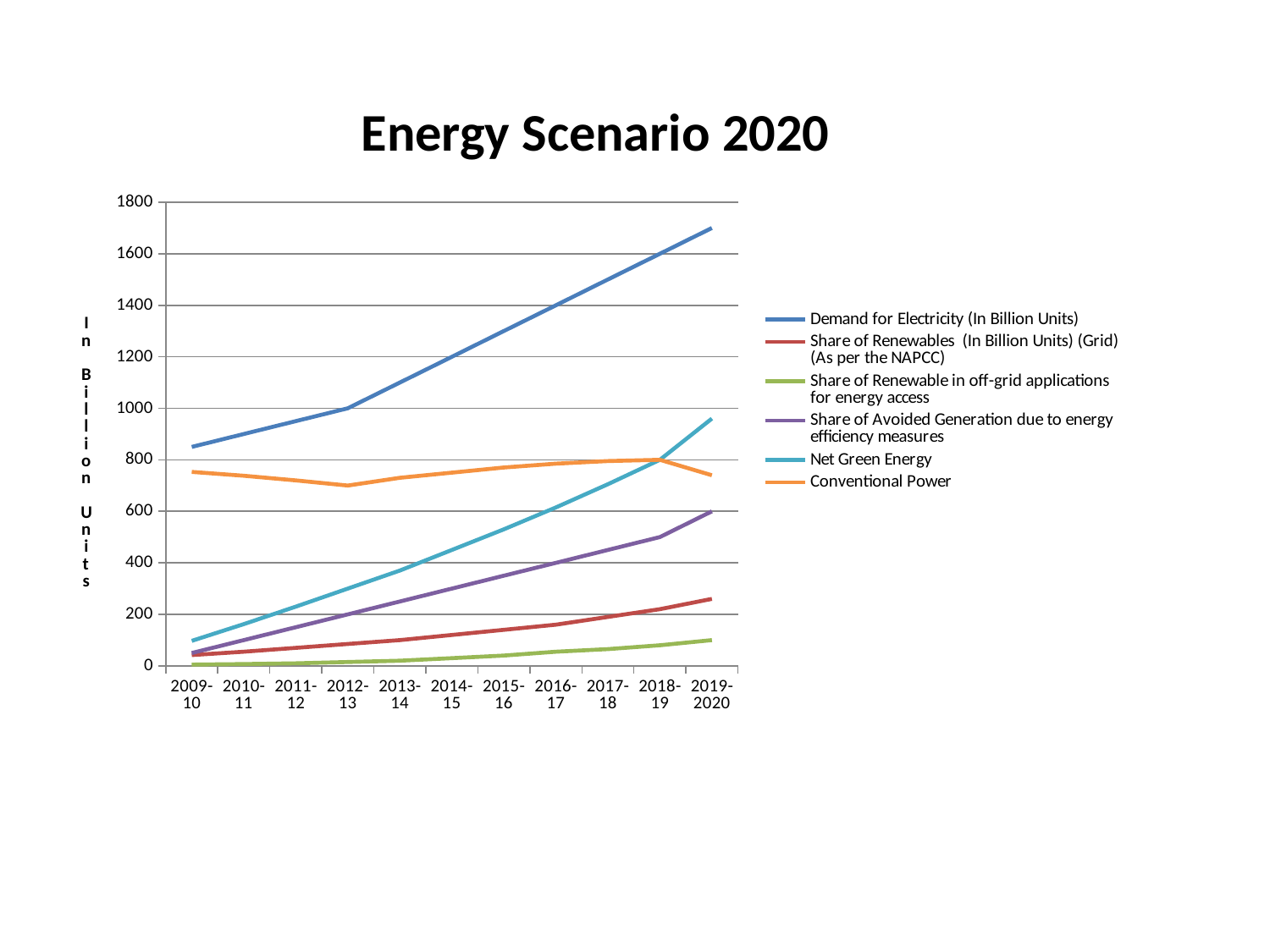
Is the value for Net Green Energy in 2019-2020 greater or less than 800? greater What kind of chart is shown on the slide? Line chart Which series has the lowest value in 2019-2020? Share of Renewable in off-grid applications for energy access What is the title of the chart? Energy Scenario 2020 Is the value for Conventional Power in 2019-2020 greater or less than 800? less Does the Demand for Electricity series rise or fall from 2009-10 to 2019-2020? Rise Is the value for Demand for Electricity in 2019-2020 greater or less than 1600? greater How many series does the legend list? 6 How many time periods are shown along the x axis? 11 In 2019-2020, which is larger: Net Green Energy or Conventional Power? Net Green Energy Which series has the highest value in 2019-2020? Demand for Electricity (In Billion Units)